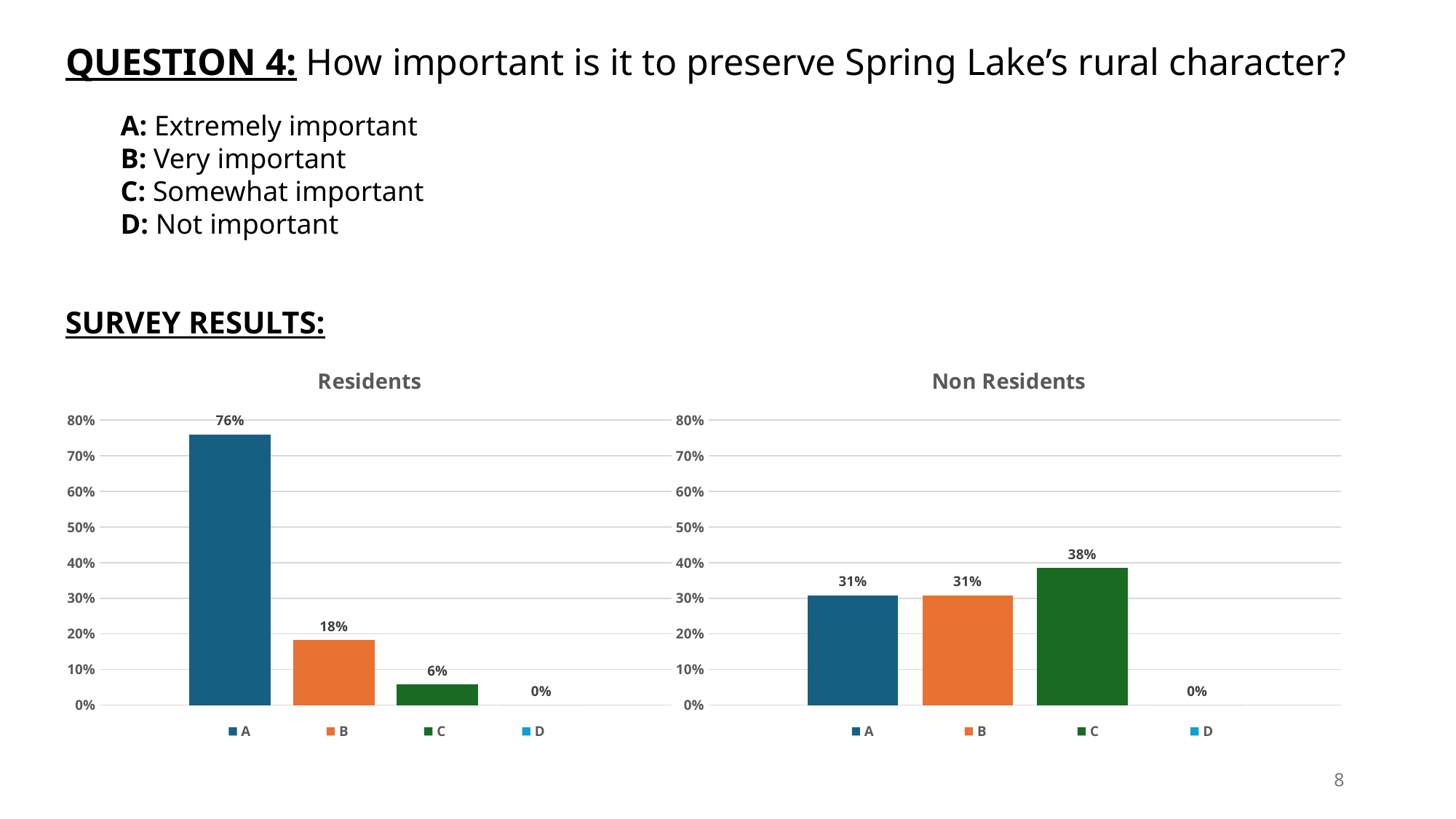
In the Non Residents chart, which category has the highest value? C How many categories are shown in the Non Residents chart? 4 In the Residents chart, which category has the highest value? A In the Non Residents chart, what is the difference between the values for C and A? 7% What kind of chart is the Residents chart? bar chart In the Residents chart, what is the difference between the values for A and B? 58% In the Residents chart, is the value for C larger or smaller than the value for B? smaller In the Residents chart, what is the value for B? 18% In the Residents chart, what is the value for A? 76% In the Non Residents chart, what is the value for D? 0% In the Residents chart, which category has the lowest value? D In the Non Residents chart, what is the value for C? 38%